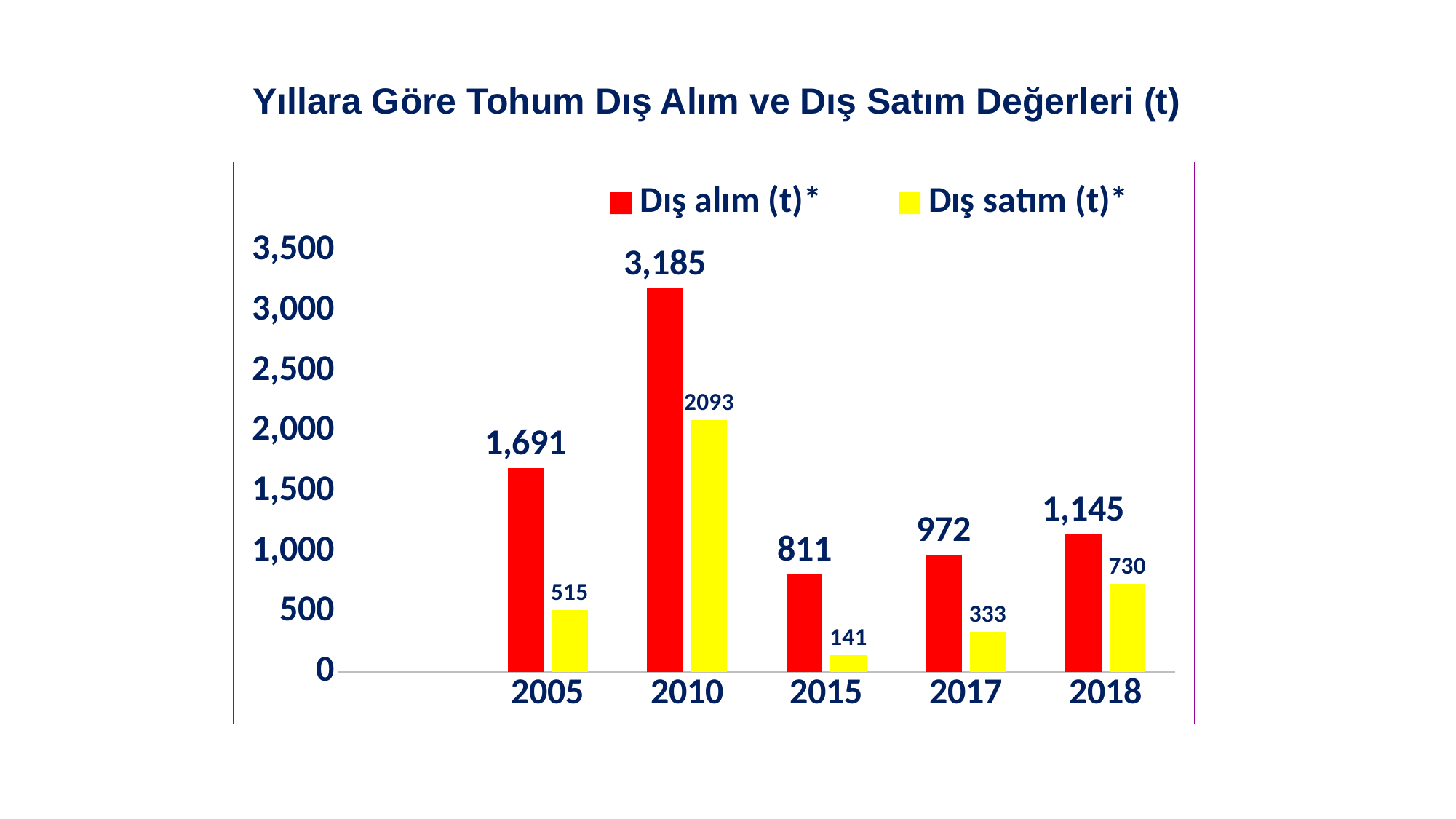
What kind of chart is shown on the slide? Bar chart What is the difference between the Dış alım (t)* and Dış satım (t)* values in 2005? 1,176 What is the Dış satım (t)* value for 2015? 141 Does the Dış alım (t)* value rise or fall from 2015 to 2018? Rise What is the Dış satım (t)* value for 2018? 730 How many years are shown on the x axis? 5 Which year has the highest Dış alım (t)* value? 2010 How many series does the legend list? 2 What is the Dış alım (t)* value for 2010? 3,185 Which year has the lowest Dış satım (t)* value? 2015 What colour represents Dış satım (t)* in the chart? Yellow Which is larger in 2017: Dış alım (t)* or Dış satım (t)*? Dış alım (t)*